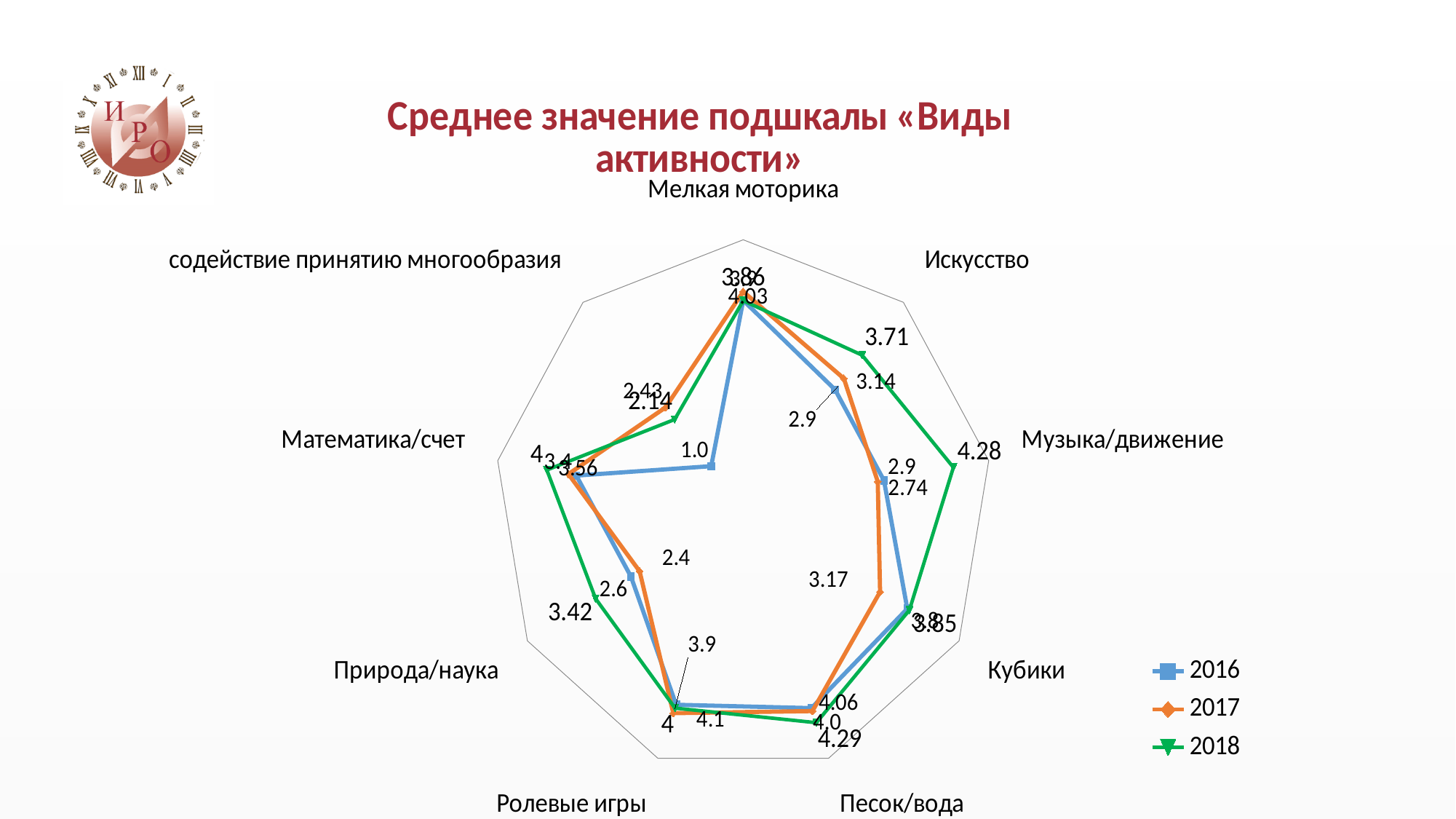
Which category has the lowest 2018 value? содействие принятию многообразия What is the difference between the 2018 and 2017 values for Природа/наука? 1.02 What is the 2018 value for Музыка/движение? 4.28 What is the 2016 value for содействие принятию многообразия? 1.0 Which category has the lowest 2016 value? содействие принятию многообразия Which series is drawn in green in the legend? 2018 What kind of chart is shown on the slide? Radar chart What is the 2018 value for Искусство? 3.71 What is the 2017 value for Природа/наука? 2.4 Which is larger for Музыка/движение: the 2016 value or the 2018 value? 2018 How many series does the legend list? 3 How many categories (axes) does the radar chart have? 9